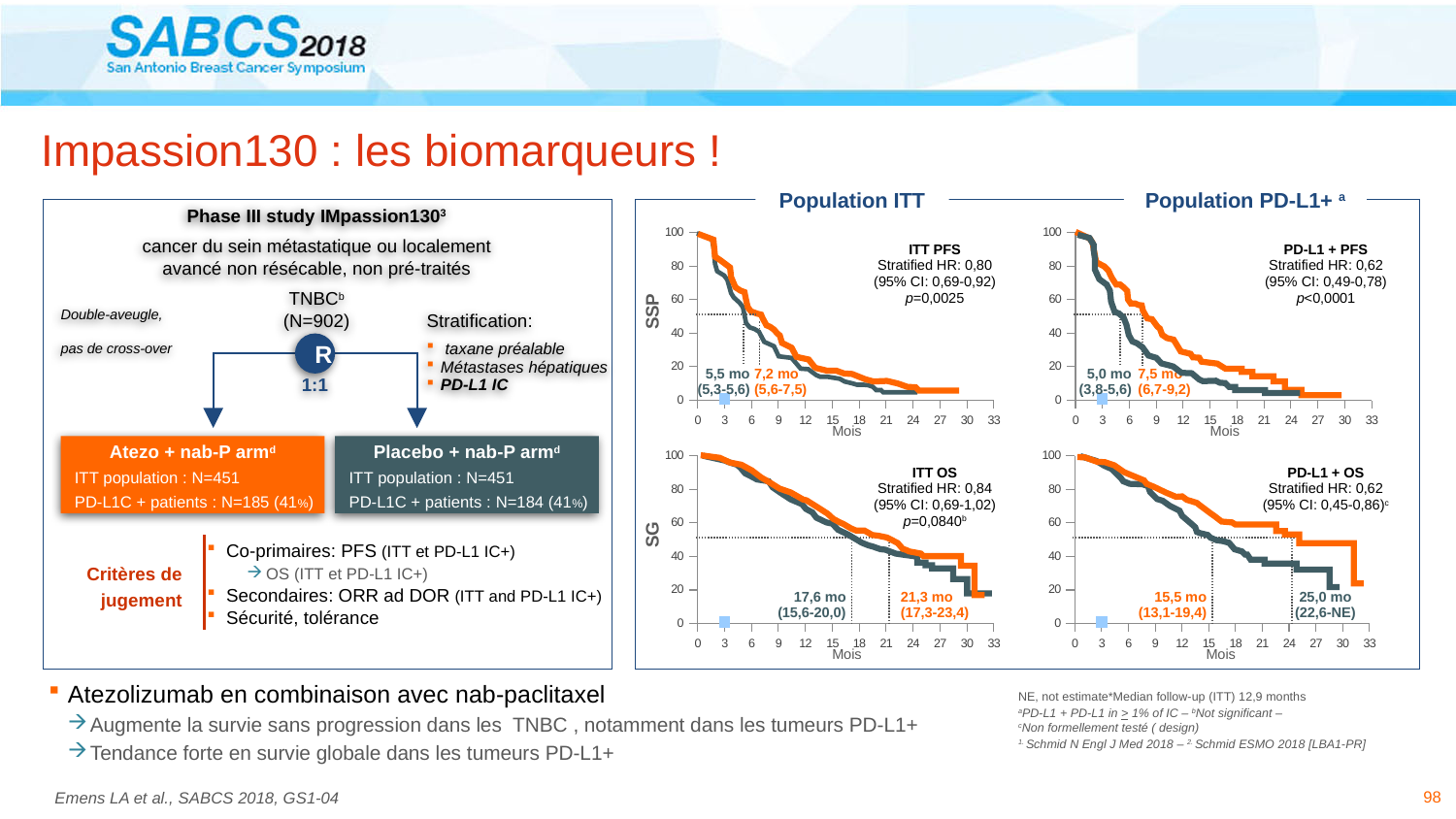
In the ITT OS chart, what is the difference between the two median OS values (21,3 mo and 17,6 mo)? 3,7 mo In the ITT PFS chart, what is the stratified hazard ratio? 0,80 In the ITT OS chart, what p-value is shown? p=0,0840 In the ITT PFS chart, what is the median PFS shown for the orange curve? 7,2 mo In the PD-L1 + OS chart, what is the difference between the two median OS values (25,0 mo and 15,5 mo)? 9,5 mo In the ITT PFS chart, do the curves rise or fall as months increase along the x axis? Fall In the PD-L1 + PFS chart, what p-value is shown? p<0,0001 In the PD-L1 + PFS chart, what is the stratified hazard ratio? 0,62 In the PD-L1 + PFS chart, what is the 95% CI of the stratified HR? 0,49-0,78 What kind of chart is the ITT OS chart? Line chart (Kaplan-Meier survival curve) How many survival curve charts are shown on the slide? 4 In the PD-L1 + OS chart, which median OS is larger, 25,0 mo or 15,5 mo? 25,0 mo